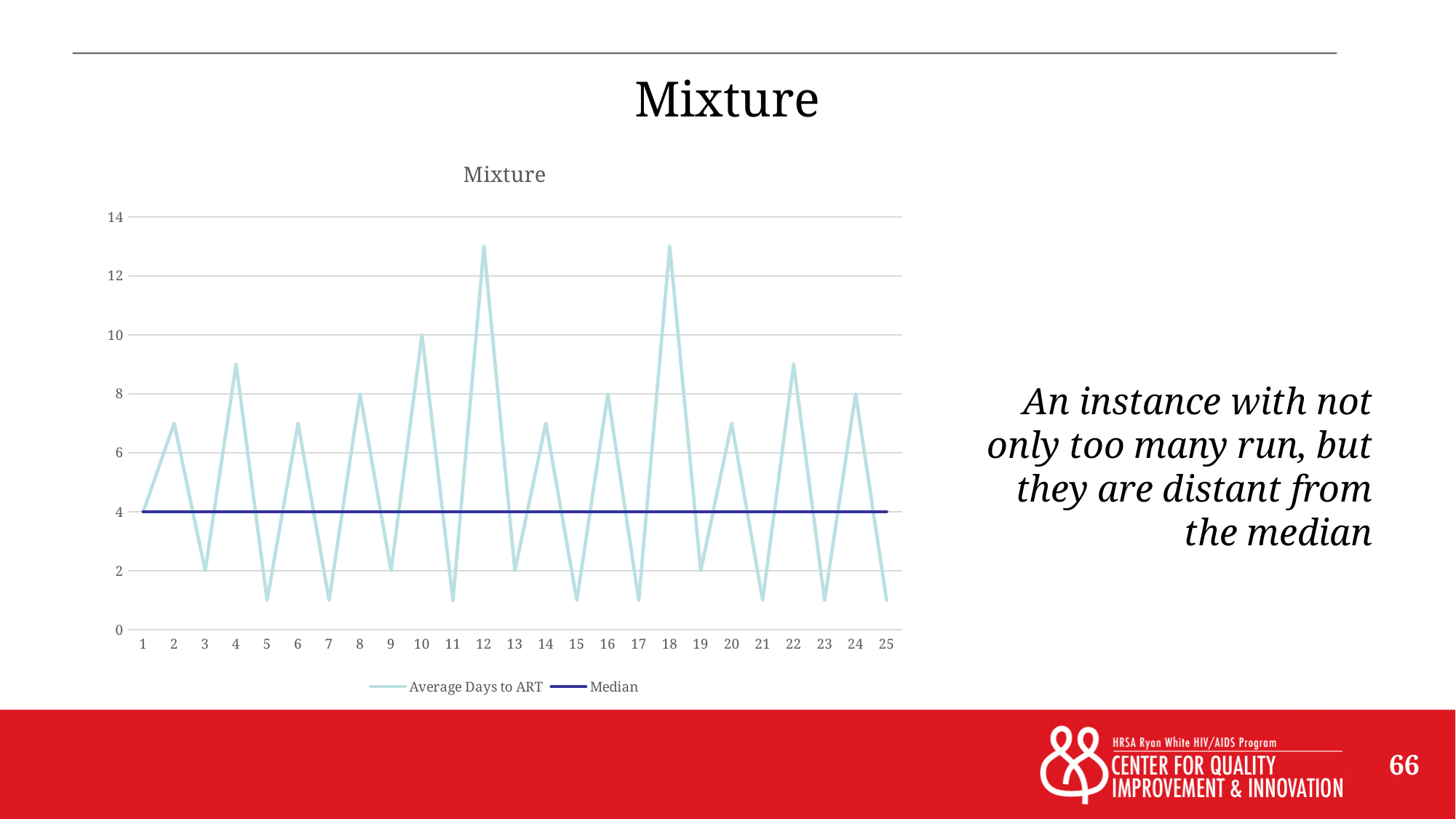
What is the value of Average Days to ART at point 1? 4 Which is larger, the Average Days to ART value at point 2 or at point 3? point 2 Is the value of Average Days to ART at point 5 greater or less than 2? less What is the value of Average Days to ART at point 10? 10 What are the two entries in the chart's legend? Average Days to ART and Median What kind of chart is shown on the slide? line chart How many points are plotted along the x axis of the chart? 25 Does the Median line rise, fall, or stay flat across the x axis? stays flat Is the value of Average Days to ART at point 12 greater or less than 12? greater What is the value of the Median line in the chart? 4 What is the title of the chart? Mixture How many series does the chart's legend list? 2